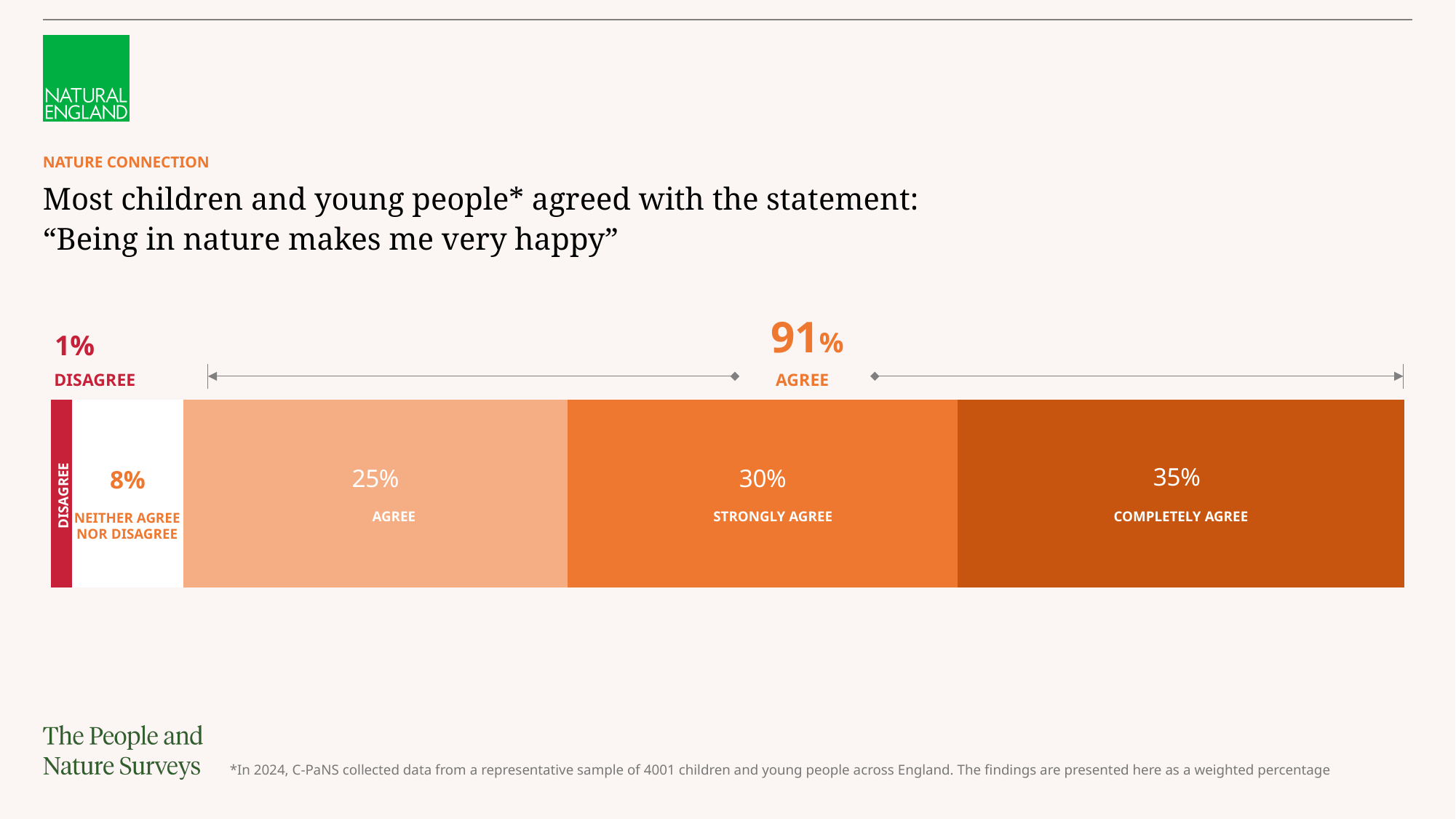
What percentage of children and young people completely agreed with the statement? 35% What percentage disagreed with the statement? 1% What kind of chart is shown on the slide? Stacked bar chart How many response categories are shown in the bar? 5 What is the combined percentage shown for all agree responses? 91% Which response category has the largest share? Completely agree What percentage neither agreed nor disagreed? 8% What is the difference between the 'Completely agree' and 'Agree' percentages? 10% Which is larger, the 'Strongly agree' share or the 'Agree' share? Strongly agree Which response category has the smallest share? Disagree What percentage strongly agreed with the statement? 30% What statement were respondents asked about? "Being in nature makes me very happy"